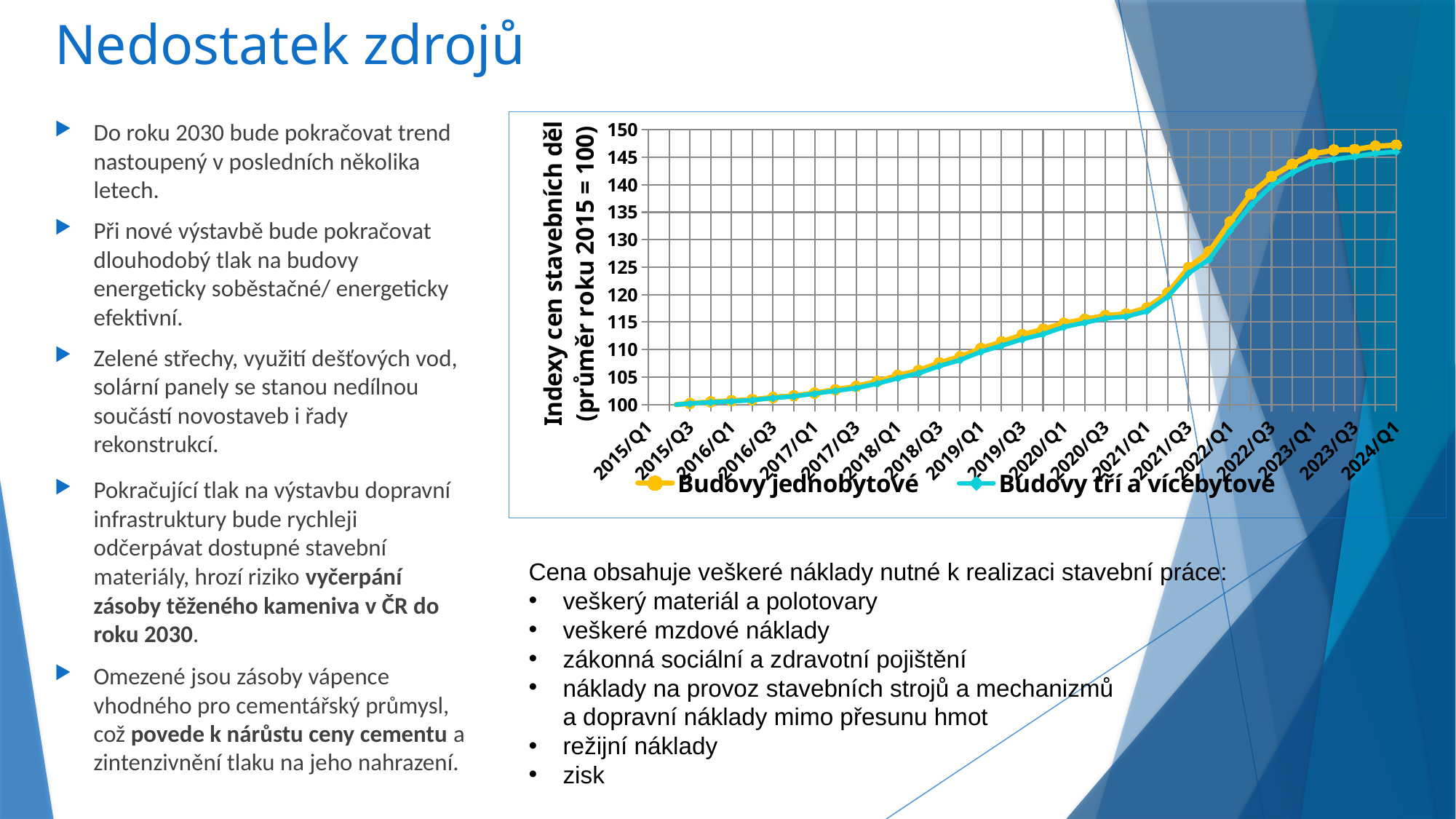
What is the title of the vertical axis of the chart? Indexy cen stavebních děl (průměr roku 2015 = 100) Is the value for Budovy tří a vícebytové at 2024/Q1 greater or less than 140? greater What are the two series named in the chart legend? Budovy jednobytové and Budovy tří a vícebytové Is the value for Budovy jednobytové at 2024/Q1 greater or less than 145? greater At which quarter does the Budovy jednobytové series reach its highest value? 2024/Q1 Do the values for Budovy jednobytové rise or fall from 2015/Q1 to 2024/Q1? rise Is the value for Budovy jednobytové at 2022/Q1 greater or less than 125? greater What kind of chart is shown on the slide? line chart How many series does the chart legend list? 2 At 2022/Q1, which series has the higher value, Budovy jednobytové or Budovy tří a vícebytové? Budovy jednobytové